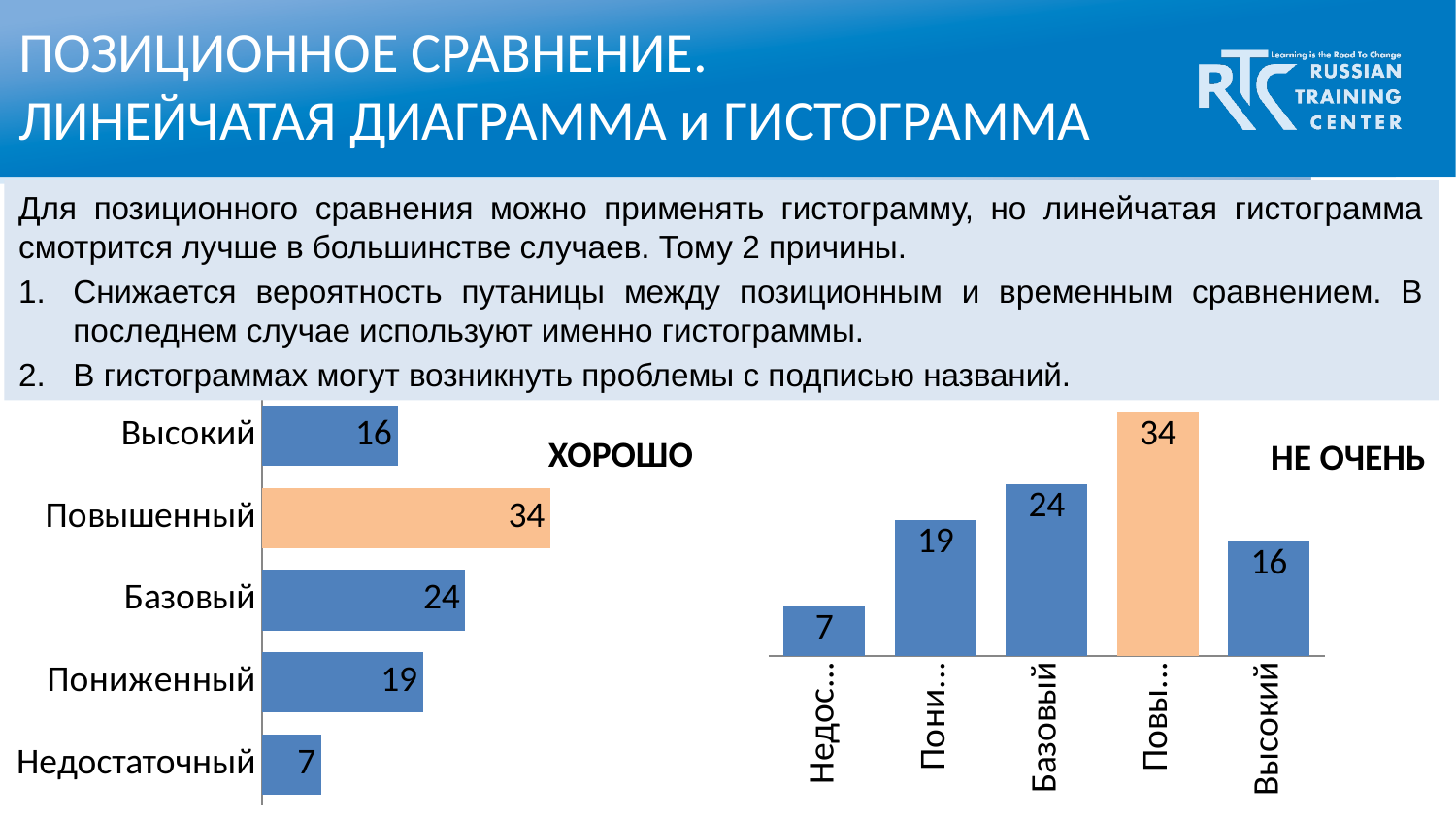
In the left chart (ХОРОШО), what is the difference between the values for Базовый and Пониженный? 5 In the right chart (НЕ ОЧЕНЬ), what is the value for Высокий? 16 How many categories are shown in the left chart (ХОРОШО)? 5 In the right chart (НЕ ОЧЕНЬ), what is the value for Базовый? 24 In the left chart (ХОРОШО), which is larger: the value for Высокий or the value for Пониженный? Пониженный In the left chart (ХОРОШО), which bar is coloured orange instead of blue? Повышенный What type of chart is the left chart (ХОРОШО)? Bar chart In the right chart (НЕ ОЧЕНЬ), what is the difference between the highest and lowest values? 27 In the left chart (ХОРОШО), what is the value for Повышенный? 34 In the left chart (ХОРОШО), what is the value for Недостаточный? 7 In the left chart (ХОРОШО), which category has the highest value? Повышенный In the left chart (ХОРОШО), which category has the lowest value? Недостаточный